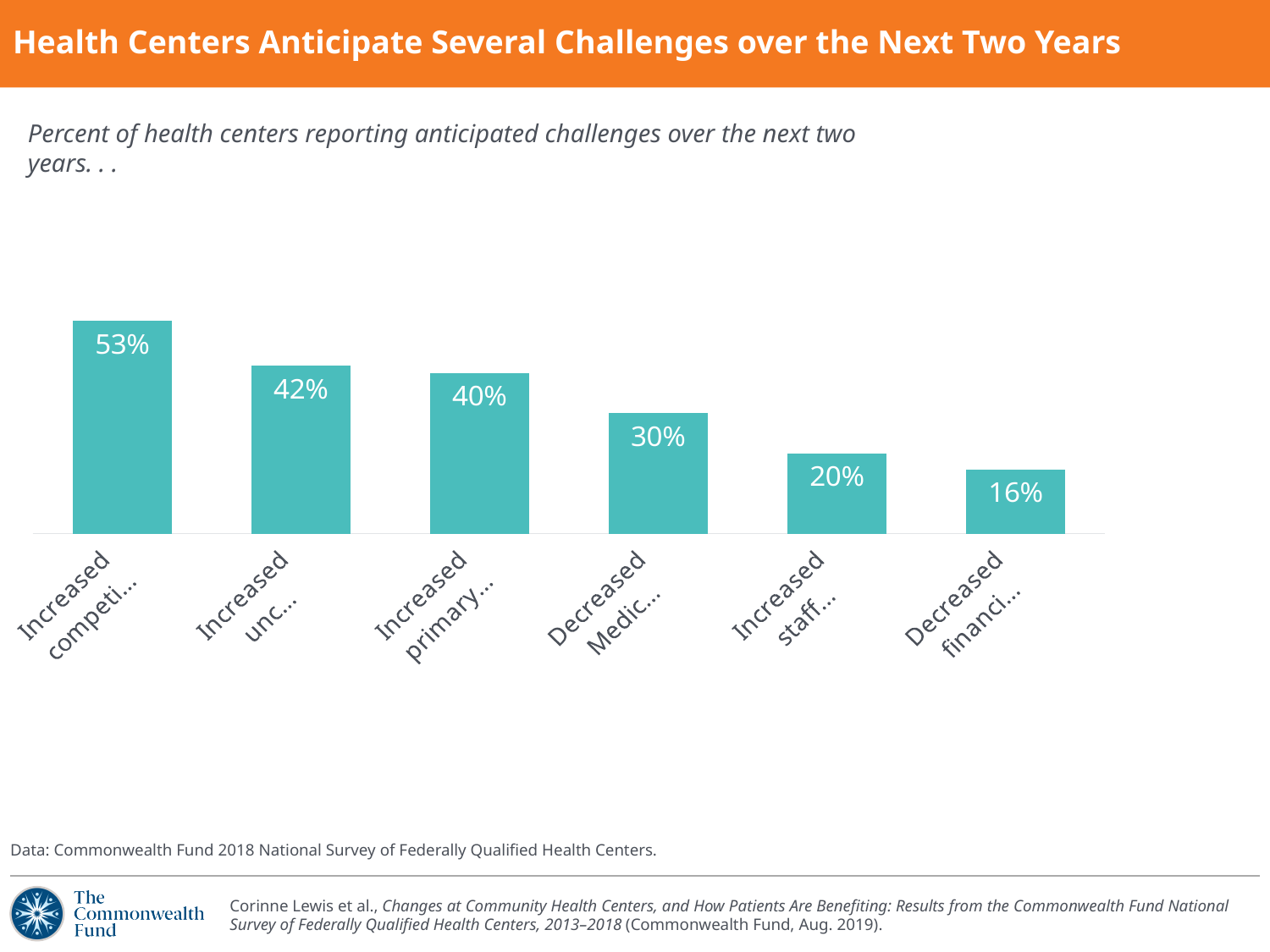
Which bar has the highest value? Increased competi... (the leftmost bar) What is the value of the second bar, labeled "Increased unc..."? 42% How many bars are plotted in the chart? 6 What is the difference between the first bar (53%) and the second bar (42%)? 11 percentage points What is the title of the slide containing the chart? Health Centers Anticipate Several Challenges over the Next Two Years What is the value of the bar labeled "Decreased Medic..."? 30% Which bar has the lowest value? Decreased financi... (the rightmost bar) What type of chart is shown on the slide? bar chart What is the value of the first (leftmost) bar, labeled "Increased competi..."? 53% Do the bar values rise or fall from left to right across the chart? fall What is the value of the last (rightmost) bar, labeled "Decreased financi..."? 16% Which is larger, the value for "Increased primary..." or the value for "Increased staff..."? Increased primary...